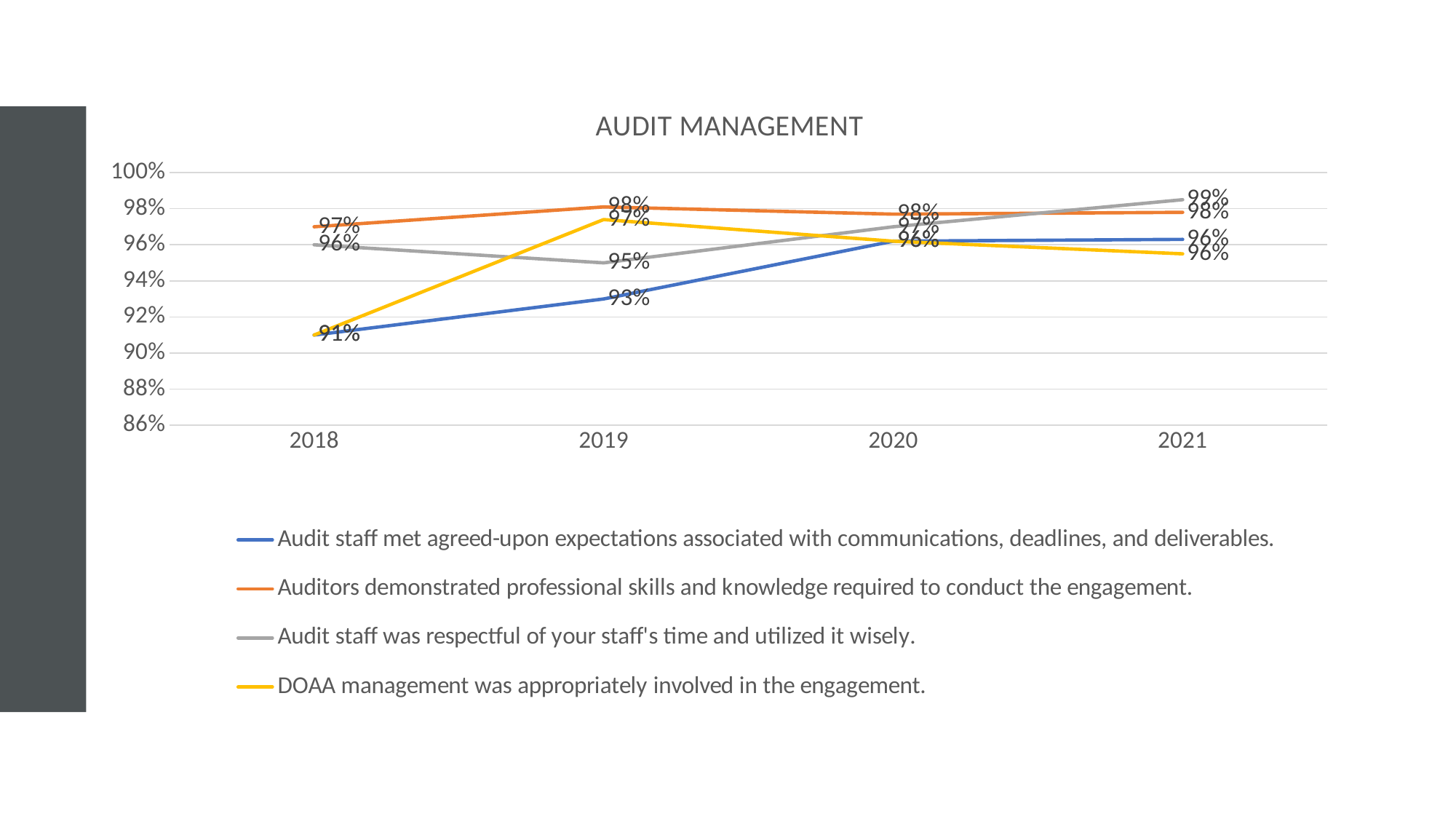
What is the 2021 value for 'Audit staff was respectful of your staff's time and utilized it wisely.'? 99% What kind of chart is shown on the slide? line chart How many series does the legend list? 4 What is the 2019 value for 'Audit staff met agreed-upon expectations associated with communications, deadlines, and deliverables.'? 93% What is the title of the chart? AUDIT MANAGEMENT How many years are shown on the x axis? 4 What is the 2019 value for 'Audit staff was respectful of your staff's time and utilized it wisely.'? 95% Which series has the highest value in 2021? Audit staff was respectful of your staff's time and utilized it wisely. In 2019, what is the difference between the value for 'Auditors demonstrated professional skills and knowledge required to conduct the engagement.' and the value for 'Audit staff met agreed-upon expectations associated with communications, deadlines, and deliverables.'? 5 percentage points Which series has the lowest value in 2019? Audit staff met agreed-upon expectations associated with communications, deadlines, and deliverables. Does the line for 'Audit staff met agreed-upon expectations associated with communications, deadlines, and deliverables.' generally rise or fall from 2018 to 2021? rise What is the 2019 value for 'Auditors demonstrated professional skills and knowledge required to conduct the engagement.'? 98%